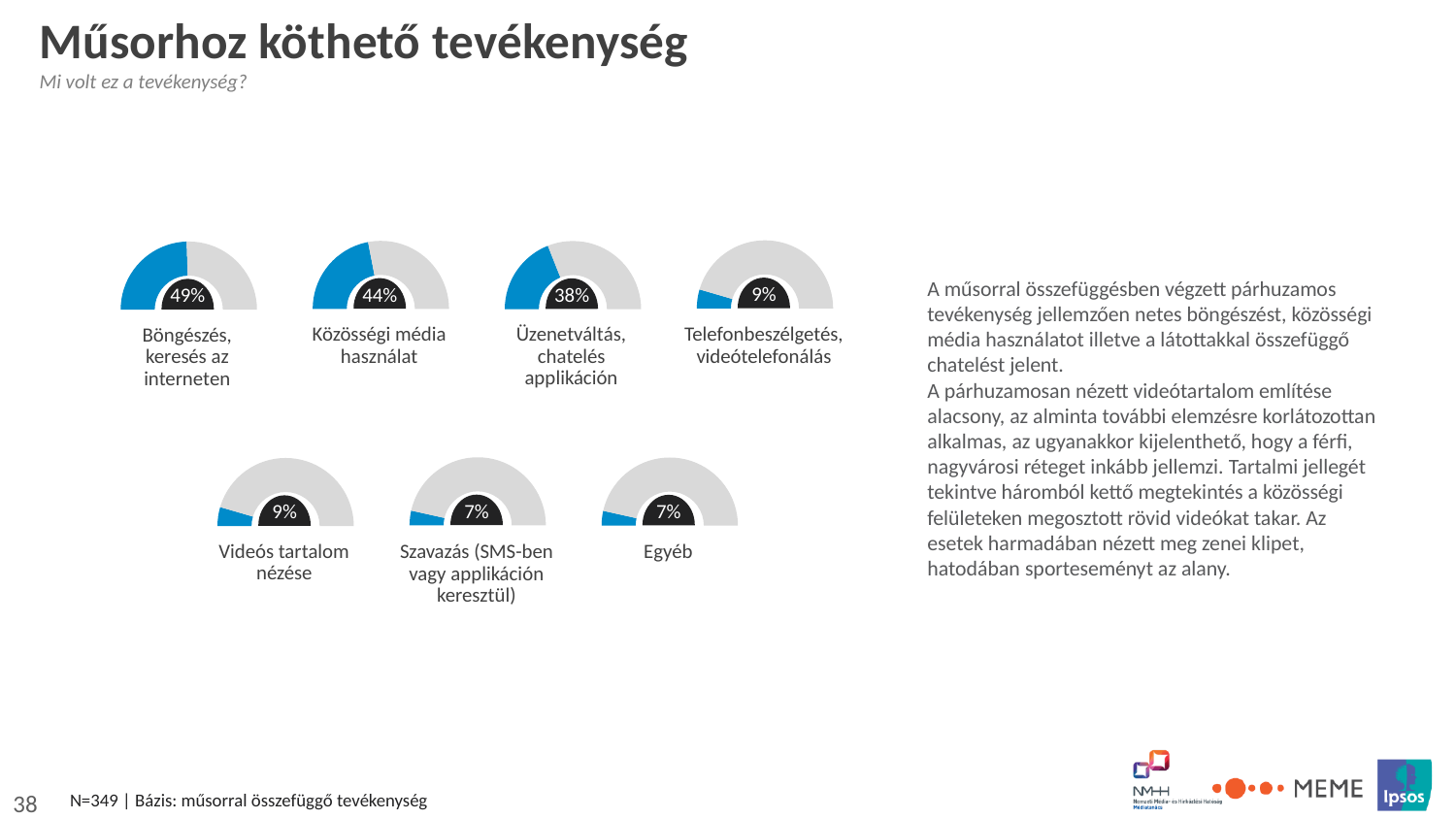
Which is larger: the value for "Közösségi média használat" or the value for "Üzenetváltás, chatelés applikáción"? Közösségi média használat What value is shown on the gauge labelled "Böngészés, keresés az interneten"? 49% What is the title of the slide containing the gauge charts? Műsorhoz köthető tevékenység What value is shown on the gauge labelled "Közösségi média használat"? 44% Across all the gauges on the slide, which activity has the highest value? Böngészés, keresés az interneten What value is shown on the gauge labelled "Szavazás (SMS-ben vagy applikáción keresztül)"? 7% What is the difference between the values for "Böngészés, keresés az interneten" and "Közösségi média használat"? 5% What kind of chart is used to display each activity's value on the slide? Gauge (semicircular doughnut) chart What value is shown on the gauge labelled "Üzenetváltás, chatelés applikáción"? 38% How many gauge charts are shown on the slide? 7 What value is shown on the gauge labelled "Telefonbeszélgetés, videótelefonálás"? 9% What is the difference between the values for "Üzenetváltás, chatelés applikáción" and "Videós tartalom nézése"? 29%